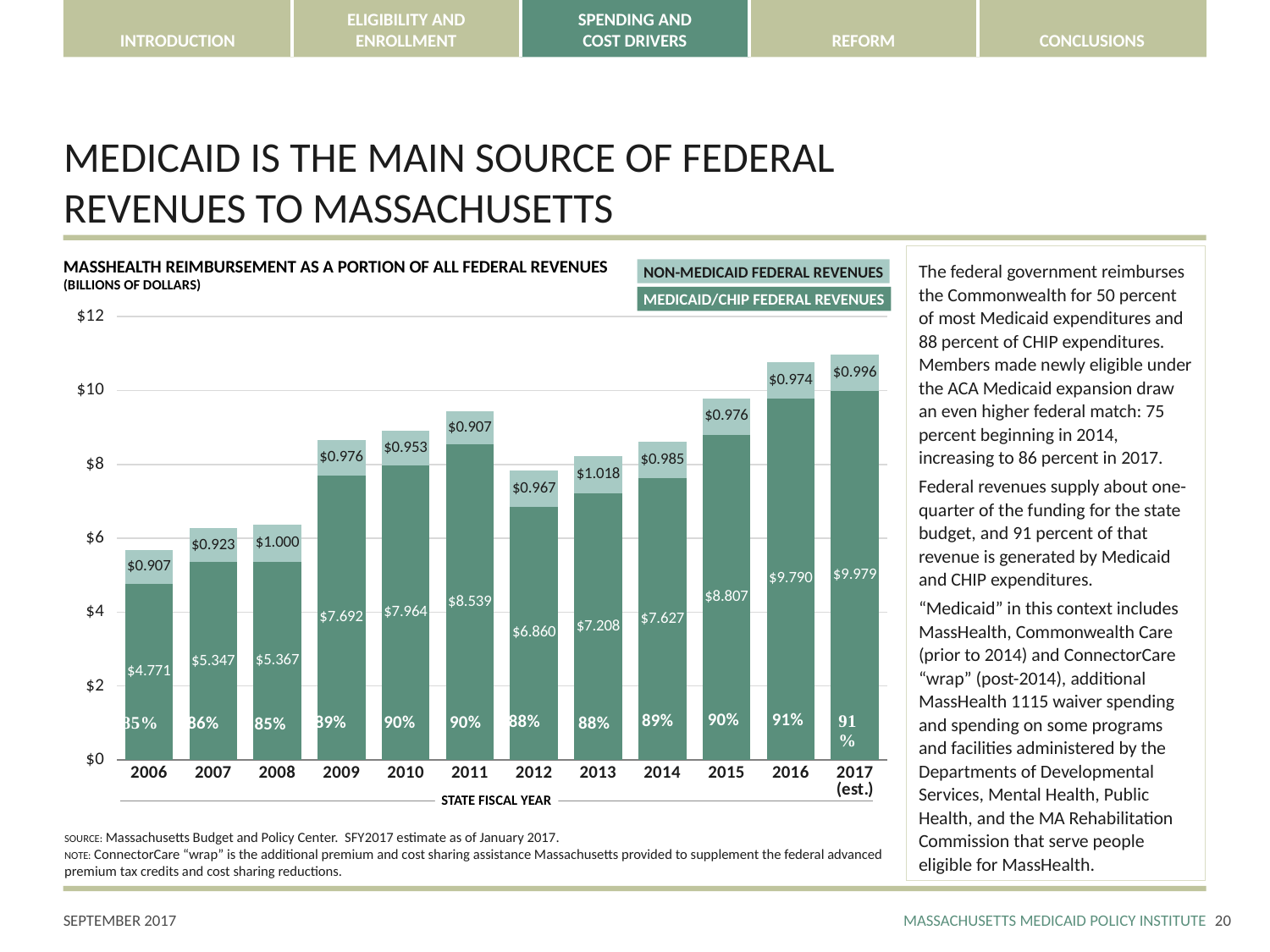
What is the difference between the Medicaid/CHIP federal revenue in 2016 and in 2015? $0.983 What is the Medicaid/CHIP federal revenue value for 2011? $8.539 Which state fiscal year has the highest Medicaid/CHIP federal revenue? 2017 (est.) What kind of chart is shown on the slide? Stacked bar chart Is the total height of the 2016 bar greater or less than $10? greater What percentage label is shown on the 2016 bar? 91% Which is larger, the Medicaid/CHIP federal revenue in 2012 or in 2014? 2014 How many series does the legend list? 2 Which state fiscal year has the lowest Medicaid/CHIP federal revenue? 2006 What is the total of the stacked bar for 2006? $5.678 What is the non-Medicaid federal revenue value for 2013? $1.018 How many state fiscal years are shown on the x axis? 12